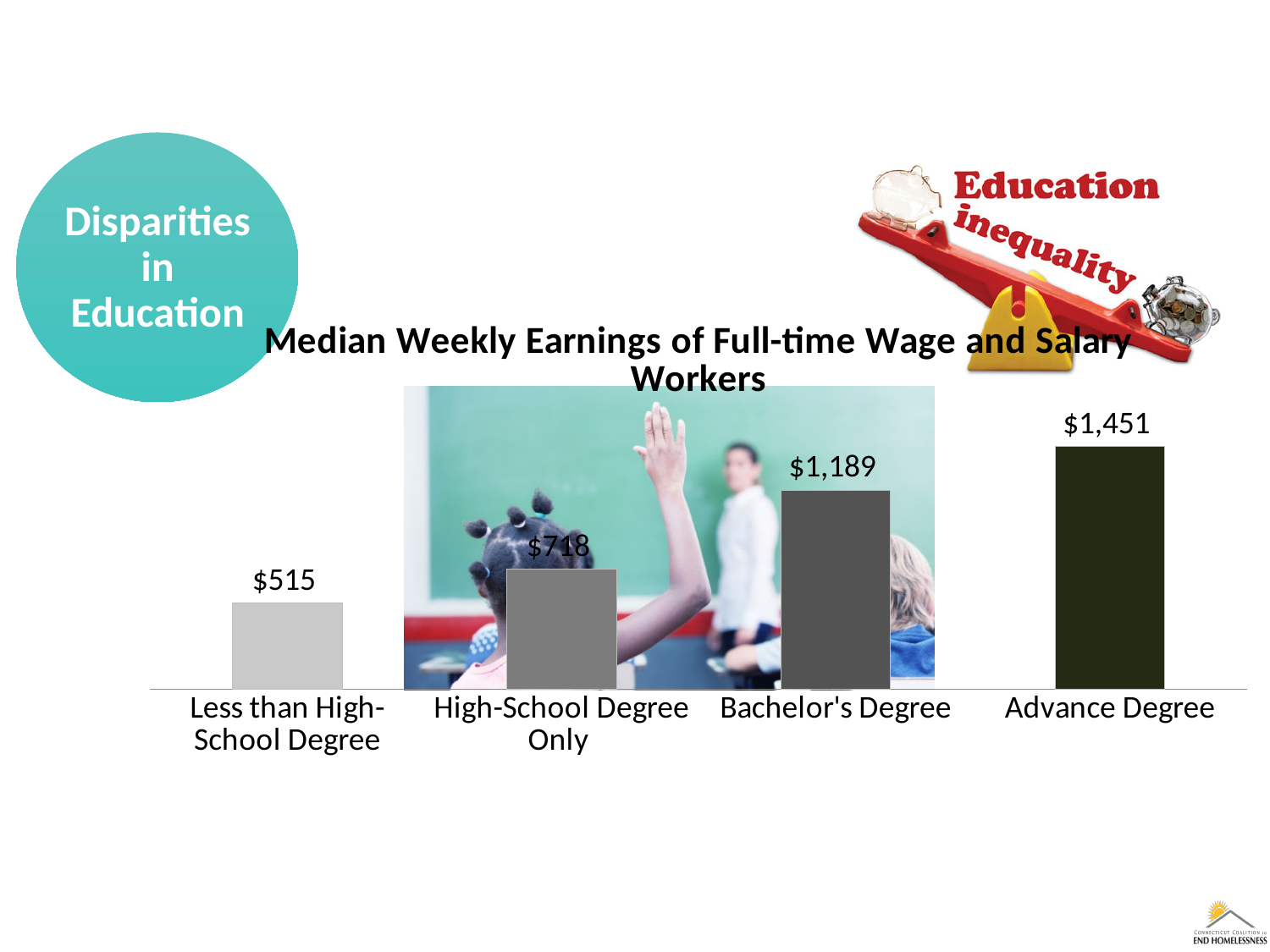
How many education categories are shown in the chart? 4 What is the value shown for High-School Degree Only? $718 Which education level has the highest median weekly earnings? Advance Degree Do the values rise or fall from left to right across the categories? Rise What kind of chart is shown on the slide? Bar chart Which education level has the lowest median weekly earnings? Less than High-School Degree What is the difference between the values for High-School Degree Only and Less than High-School Degree? $203 What is the median weekly earnings value for Bachelor's Degree? $1,189 What is the value shown for Advance Degree? $1,451 What is the median weekly earnings value for Less than High-School Degree? $515 Which is larger, the value for Bachelor's Degree or the value for High-School Degree Only? Bachelor's Degree What is the difference between the values for Advance Degree and Bachelor's Degree? $262